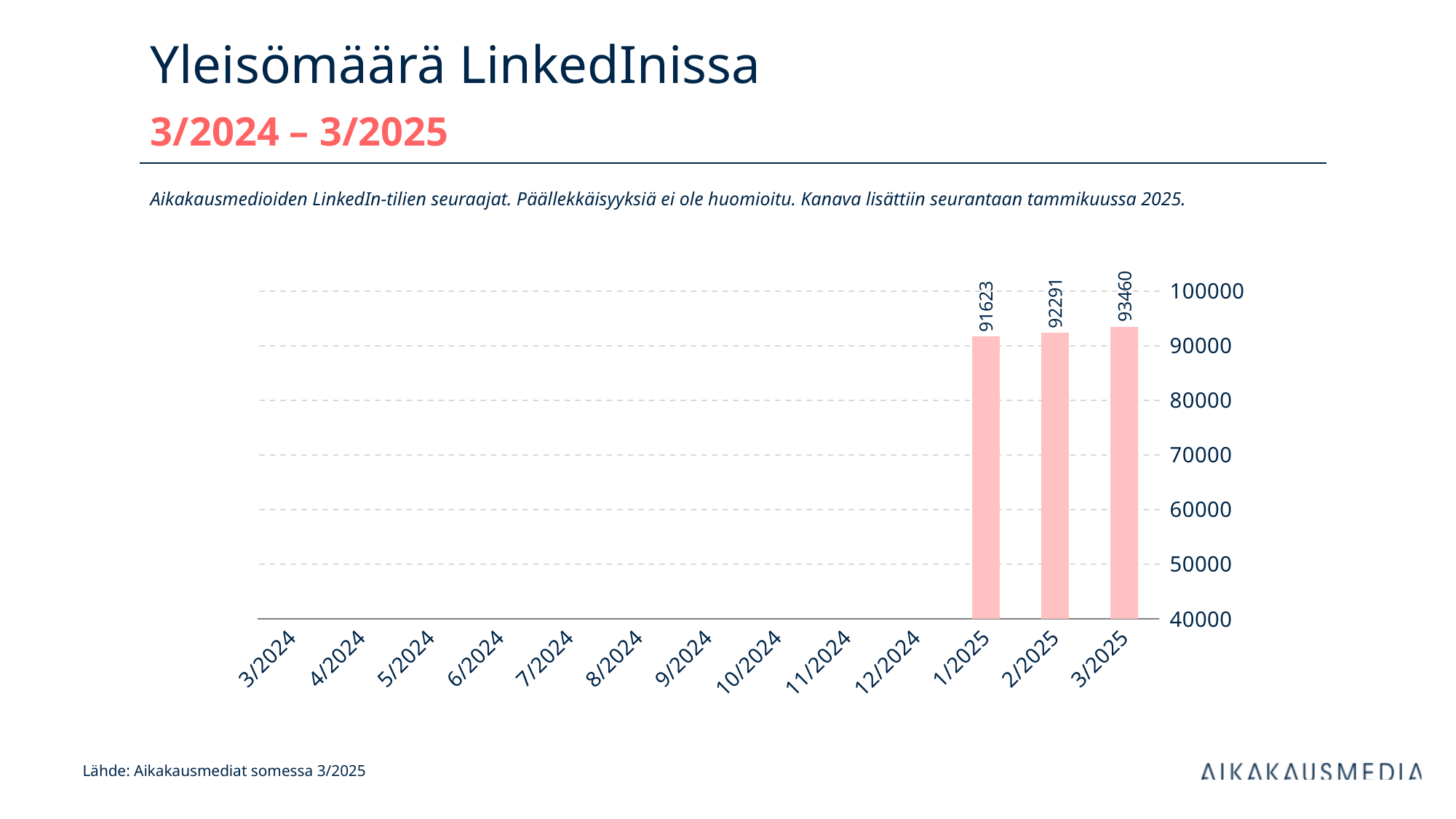
What is the value for 3/2025? 93460 Which is larger, the value for 2/2025 or the value for 3/2025? 3/2025 What is the difference between the values for 2/2025 and 1/2025? 668 Among the months with a plotted bar, which has the lowest value? 1/2025 What is the value for 2/2025? 92291 What kind of chart is shown? bar chart What is the value for 1/2025? 91623 Is the value for 1/2025 greater or less than 90000? greater How many months are labelled on the x axis? 13 What is the difference between the values for 3/2025 and 1/2025? 1837 Which month has the highest value? 3/2025 Do the values rise or fall from 1/2025 to 3/2025? rise